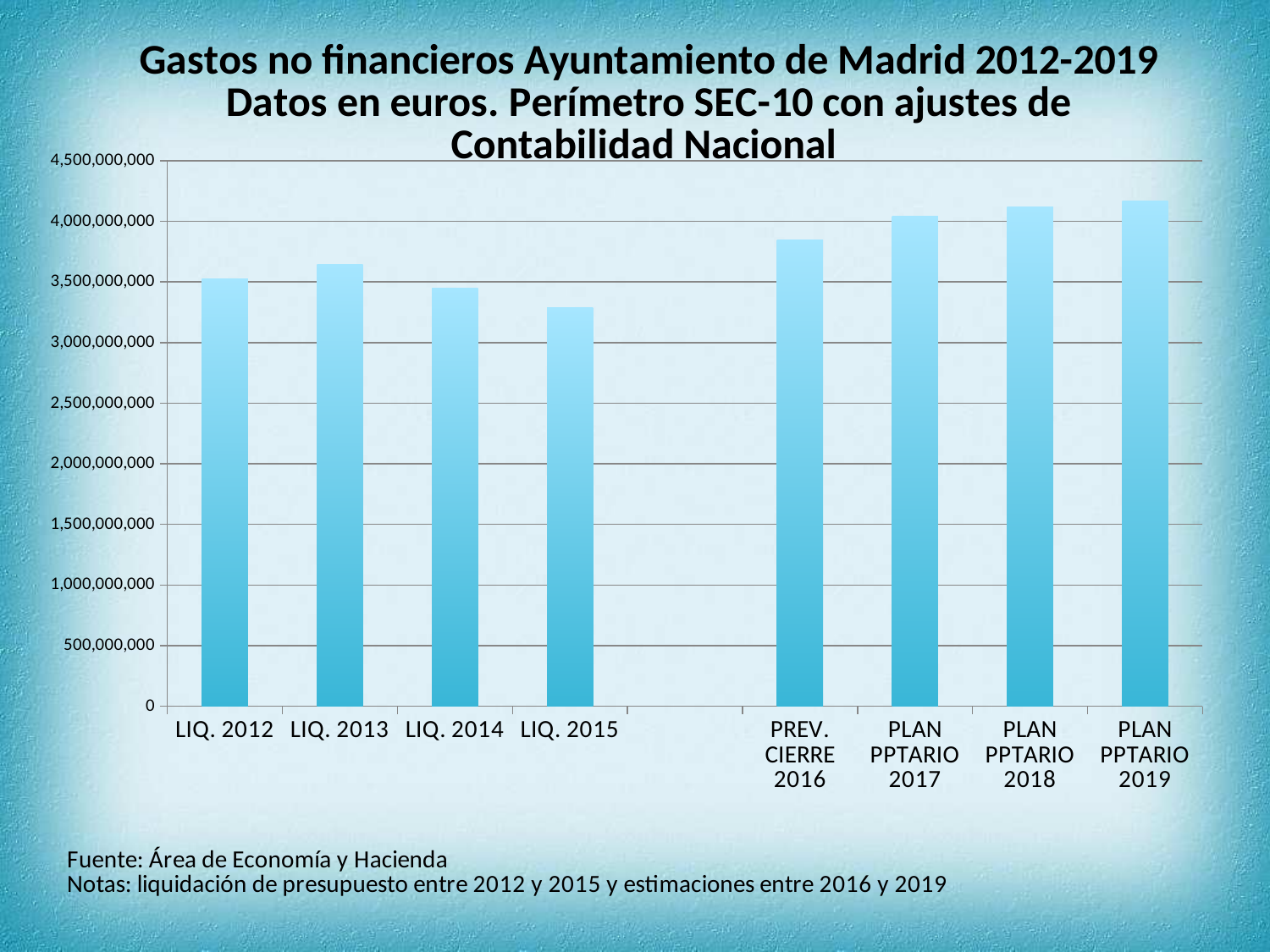
What is the highest value shown on the vertical axis of the chart? 4,500,000,000 What kind of chart is shown on the slide? Bar chart Is the value for LIQ. 2013 greater or less than 3,500,000,000? greater Is the value for PREV. CIERRE 2016 greater or less than 4,000,000,000? less How many bars (categories) are plotted in the chart? 8 Which is larger, the value for LIQ. 2015 or the value for PREV. CIERRE 2016? PREV. CIERRE 2016 Which is larger, the value for LIQ. 2013 or the value for LIQ. 2014? LIQ. 2013 Is the value for PLAN PPTARIO 2018 greater or less than 4,000,000,000? greater Do the values rise or fall from LIQ. 2015 to PLAN PPTARIO 2019? rise Do the values rise or fall from LIQ. 2013 to LIQ. 2015? fall Which category has the lowest value in the chart? LIQ. 2015